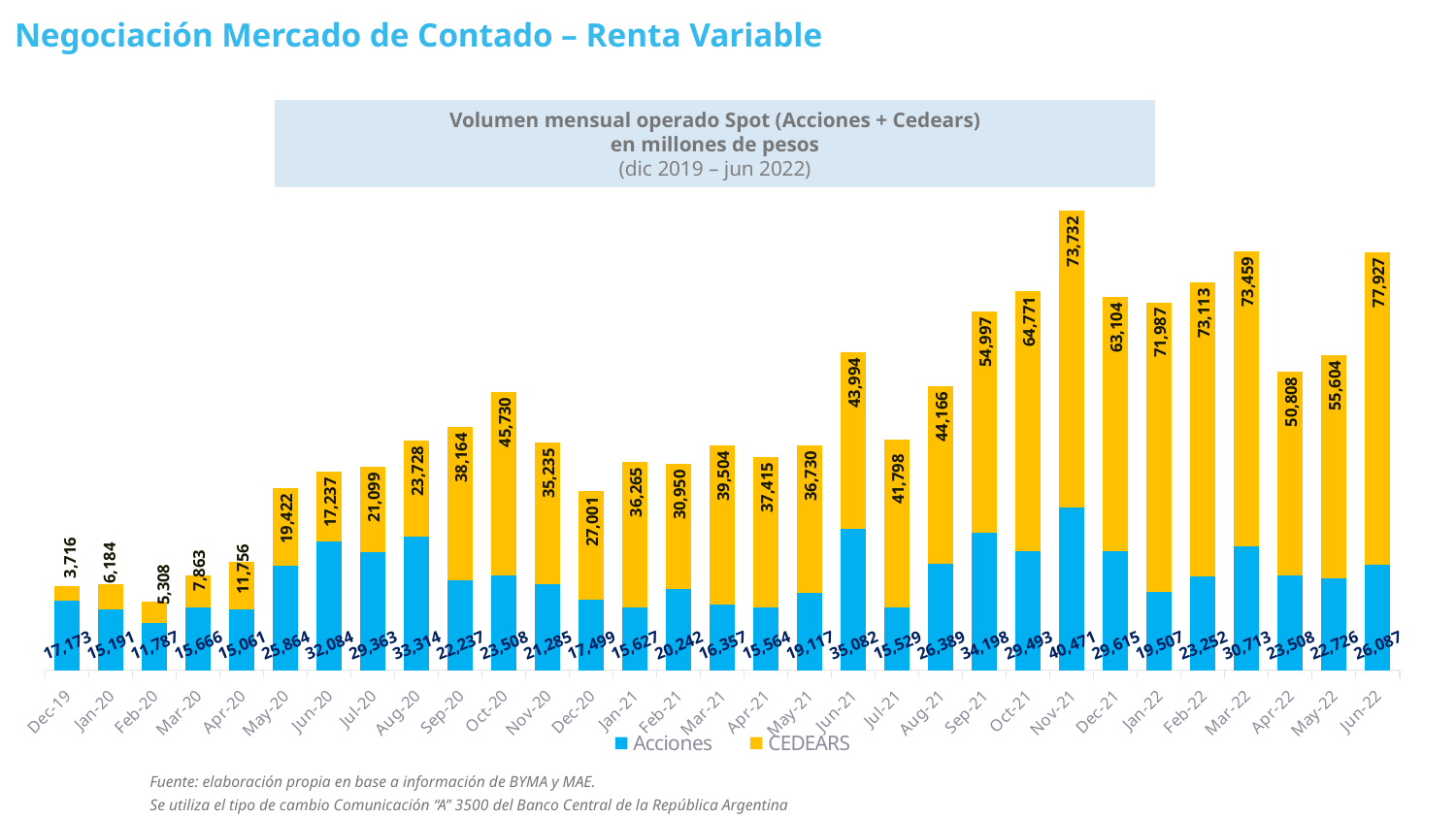
Which month has the highest Acciones value? Nov-21 Which month has the lowest Acciones value? Feb-20 What is the Acciones value for Jun-20? 32,084 What is the difference between the CEDEARS value for Jun-22 and the CEDEARS value for Nov-21? 4,195 What is the CEDEARS value for Nov-21? 73,732 How many series does the legend list? 2 How many months are shown on the x axis? 31 What is the CEDEARS value for Dec-19? 3,716 In Oct-20, which is larger: the Acciones value or the CEDEARS value? CEDEARS What kind of chart is shown on the slide? Stacked bar chart What is the total of the stacked bar for Nov-21 (Acciones + CEDEARS)? 114,203 Which month has the highest CEDEARS value? Jun-22